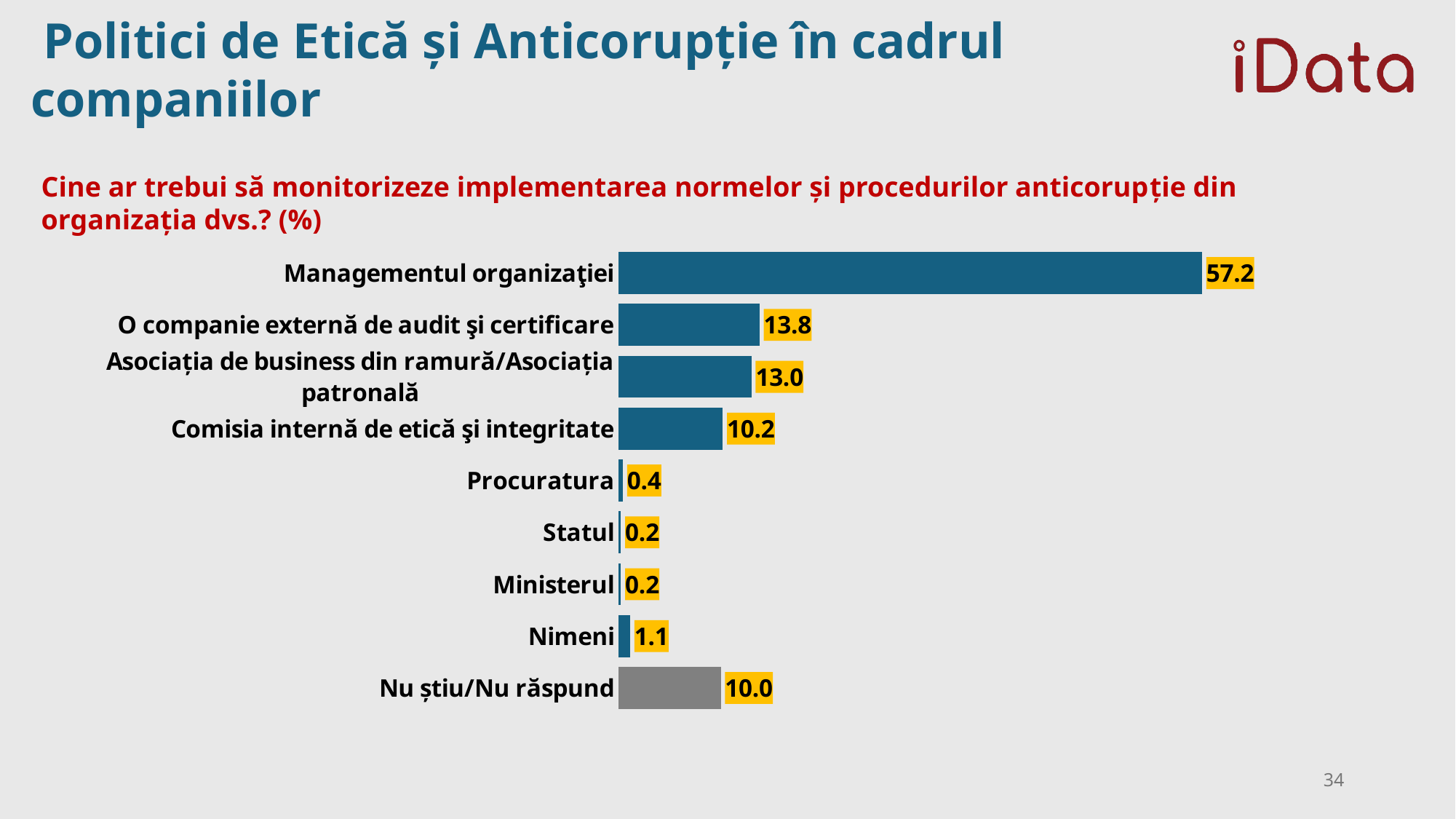
Which is larger, the value for Procuratura or the value for Nimeni? Nimeni What is the value for Comisia internă de etică şi integritate? 10.2 Which category has the highest value? Managementul organizaţiei What is the difference between the values for Managementul organizaţiei and Comisia internă de etică şi integritate? 47.0 What is the value for Statul? 0.2 What is the value for Nu știu/Nu răspund? 10.0 What is the value for Managementul organizaţiei? 57.2 Which category's bar is coloured grey rather than blue? Nu știu/Nu răspund How many categories are shown in the chart? 9 What is the difference between the values for O companie externă de audit şi certificare and Asociația de business din ramură/Asociația patronală? 0.8 What kind of chart is shown on the slide? bar chart What is the value for O companie externă de audit şi certificare? 13.8